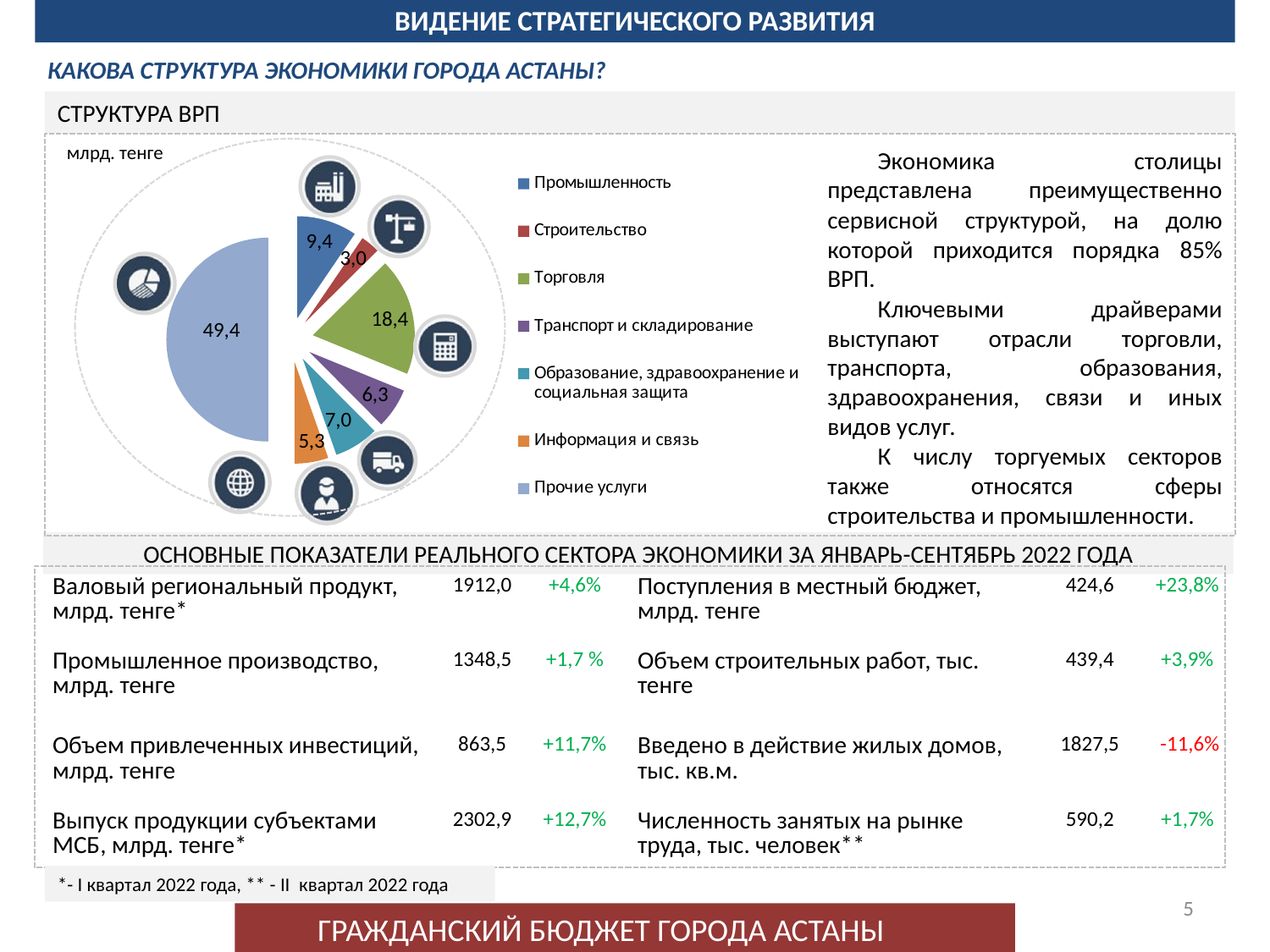
In the СТРУКТУРА ВРП pie chart, what is the difference between the values for Торговля and Промышленность? 9,0 How many categories does the СТРУКТУРА ВРП pie chart show? 7 In the СТРУКТУРА ВРП pie chart, which category has the largest value? Прочие услуги In the СТРУКТУРА ВРП pie chart, which is larger: Образование, здравоохранение и социальная защита or Транспорт и складирование? Образование, здравоохранение и социальная защита In the СТРУКТУРА ВРП pie chart, what is the difference between the values for Прочие услуги and Торговля? 31,0 What unit is indicated in the top-left corner of the СТРУКТУРА ВРП pie chart? млрд. тенге In the СТРУКТУРА ВРП pie chart, what is the value for Торговля? 18,4 In the СТРУКТУРА ВРП pie chart, which category has the smallest value? Строительство In the СТРУКТУРА ВРП pie chart, what is the value for Промышленность? 9,4 In the СТРУКТУРА ВРП pie chart, what is the value for Информация и связь? 5,3 What type of chart is shown under the heading СТРУКТУРА ВРП? pie chart In the СТРУКТУРА ВРП pie chart, what is the value for Транспорт и складирование? 6,3